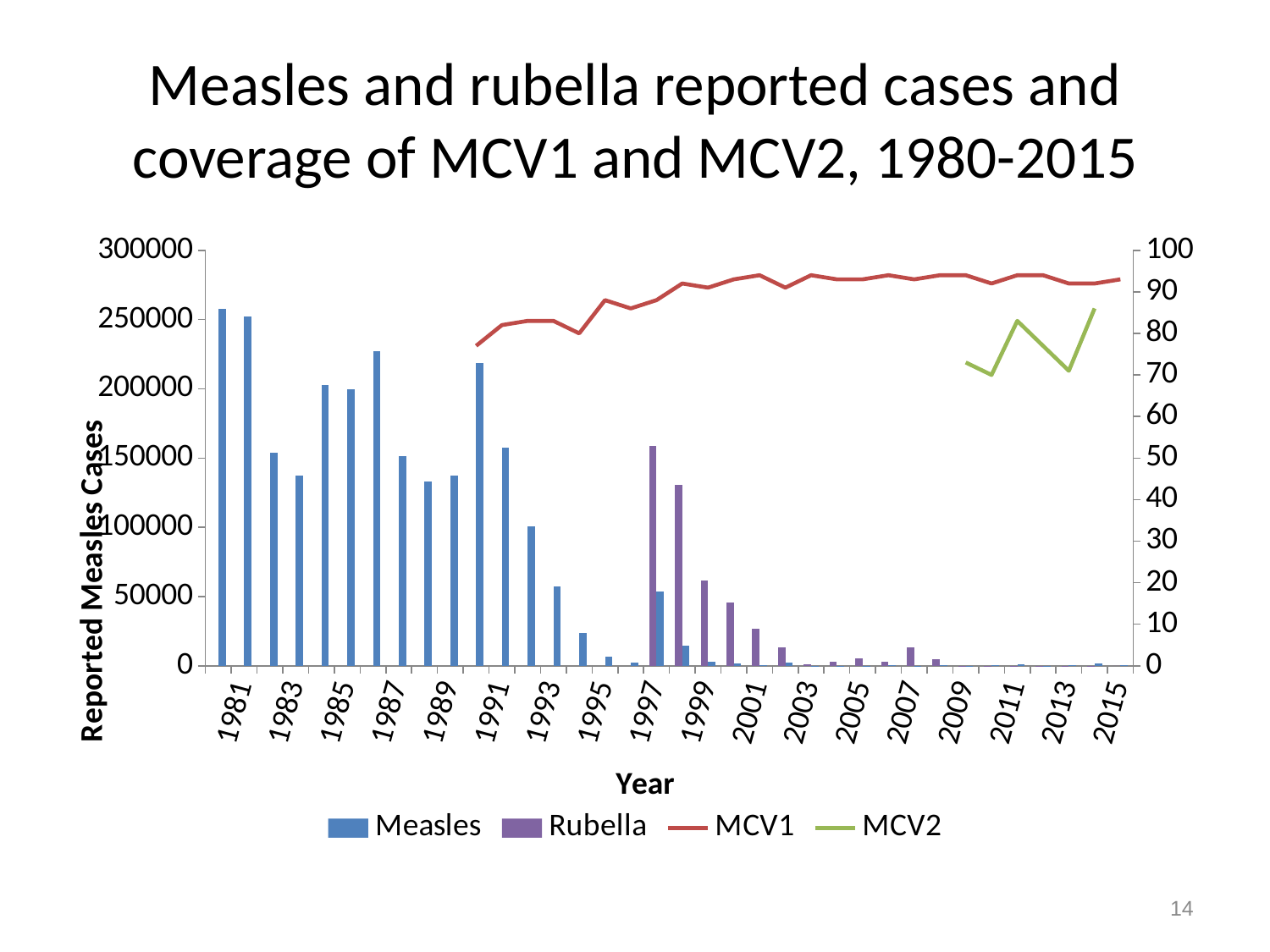
Does the MCV1 line generally rise or fall from 1990 to 2015? rise What kind of chart is this? Combination bar and line chart Is the value for Rubella in 2001 greater or less than 50000? less Is the value for Measles in 1981 greater or less than 200000? greater Is the value for Measles in 1989 greater or less than 100000? greater What is the title of the horizontal axis? Year What is the title of the left vertical axis? Reported Measles Cases Which is larger, the Measles value for 1983 or for 1985? 1985 How many series does the legend list? 4